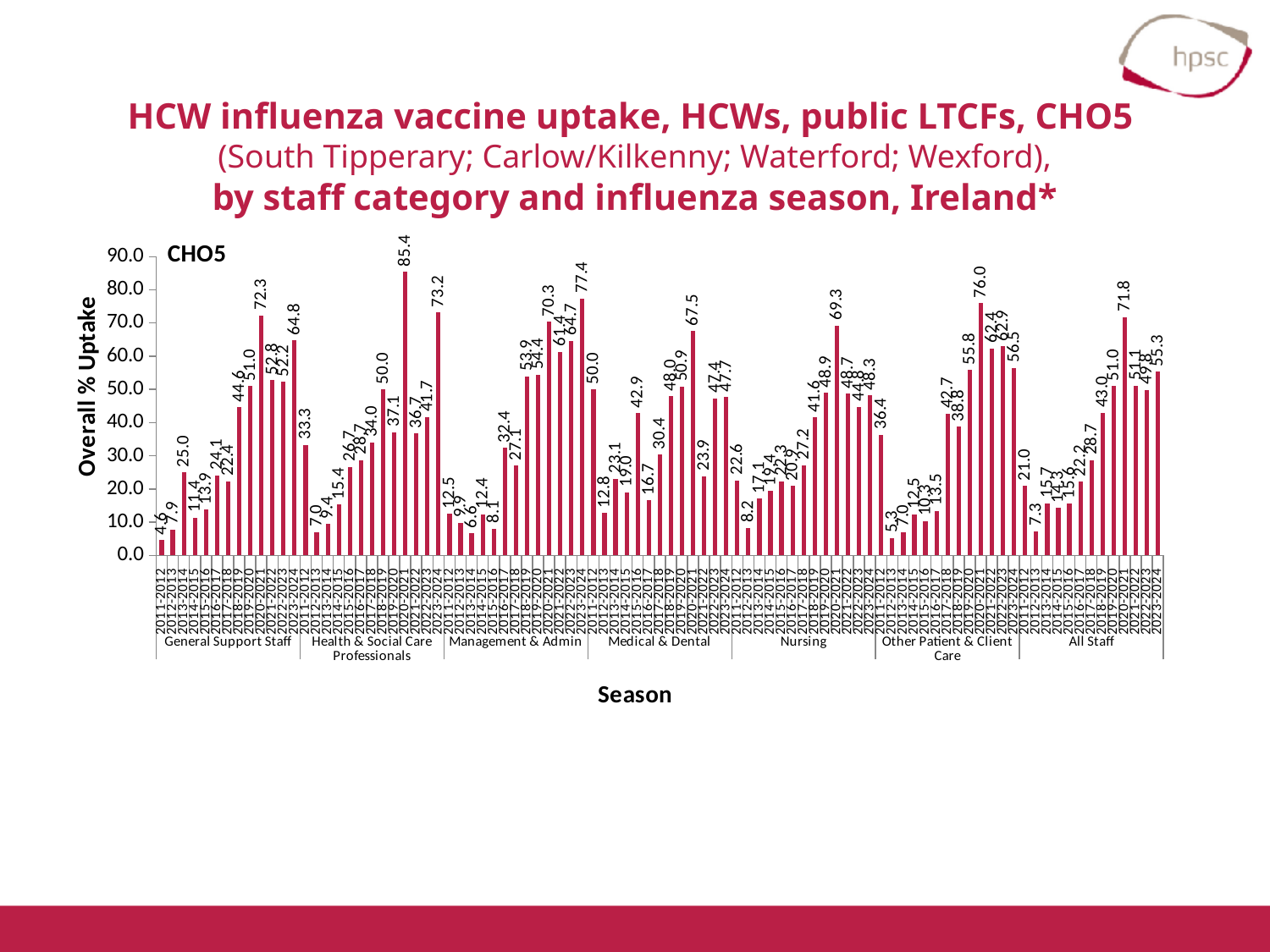
What is the uptake value for General Support Staff in the 2020-2021 season? 72.3 How many seasons are plotted for each staff category? 13 What is the title of the y axis? Overall % Uptake What type of chart is shown on the slide? bar chart Within the Nursing category, which season has the lowest uptake? 2012-2013 Which is larger for the 2023-2024 season: Health & Social Care Professionals or General Support Staff? Health & Social Care Professionals How many staff categories are shown along the x axis? 7 What is the uptake value for All Staff in the 2020-2021 season? 71.8 Is the Nursing value for 2023-2024 greater or less than 40.0? greater What is the uptake value for Management & Admin in the 2023-2024 season? 77.4 What is the difference between the Health & Social Care Professionals value for 2020-2021 (85.4) and the General Support Staff value for 2020-2021 (72.3)? 13.1 What is the highest value shown in the chart, and for which staff category and season? 85.4, Health & Social Care Professionals, 2020-2021